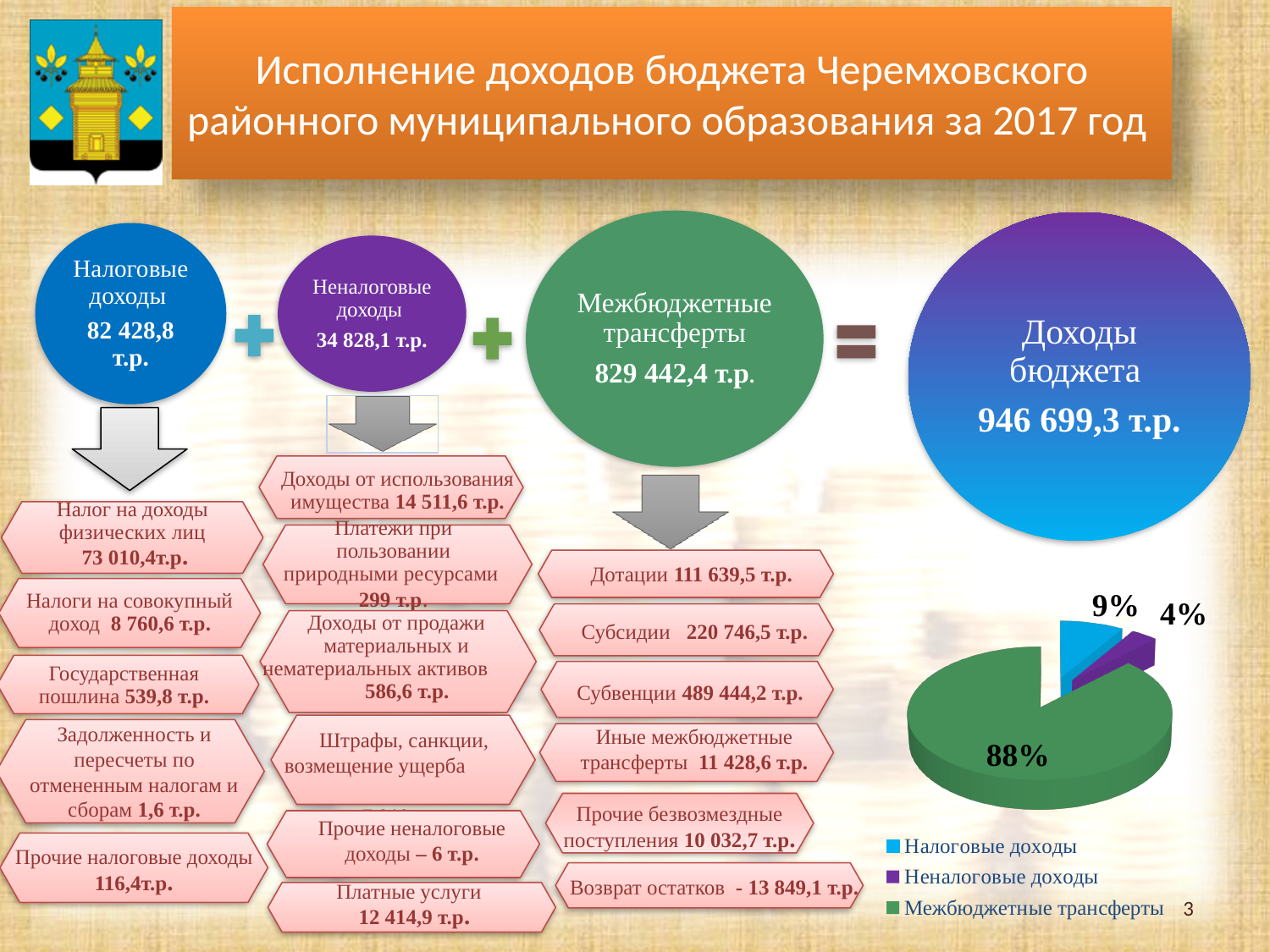
How many slices does the pie chart have? 3 By how many percentage points does the Межбюджетные трансферты slice exceed the Налоговые доходы slice? 79 percentage points By how many percentage points does the Налоговые доходы slice exceed the Неналоговые доходы slice? 5 percentage points How many entries does the pie chart's legend list? 3 In the pie chart, which is larger: Налоговые доходы or Неналоговые доходы? Налоговые доходы In the pie chart, what share is shown for Налоговые доходы? 9% What colour is the Межбюджетные трансферты slice in the pie chart? green Which category has the largest slice in the pie chart? Межбюджетные трансферты What kind of chart is shown on the slide? pie chart In the pie chart, what share is shown for Неналоговые доходы? 4% Which category has the smallest slice in the pie chart? Неналоговые доходы In the pie chart, what share is shown for Межбюджетные трансферты? 88%